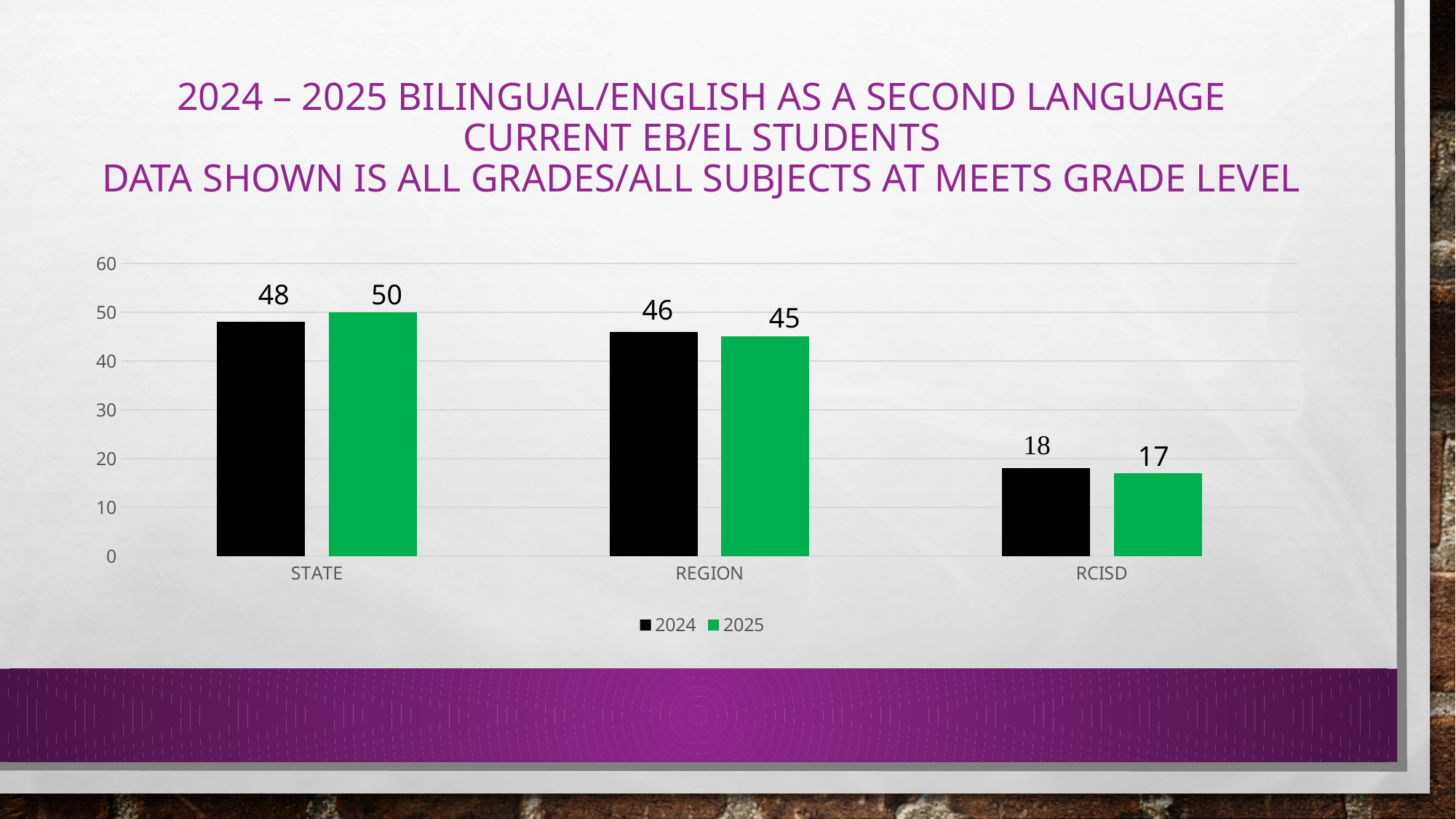
What is the 2025 value for RCISD? 17 How many categories are shown on the x axis? 3 Is the 2024 value for RCISD greater or less than 20? less Which category has the lowest 2024 value? RCISD Which is larger for REGION, the 2024 value or the 2025 value? 2024 What is the 2025 value for REGION? 45 What is the difference between the 2025 and 2024 values for STATE? 2 How many series does the legend list? 2 What kind of chart is shown on the slide? bar chart Which category has the highest 2025 value? STATE What is the difference between the 2024 values for REGION and RCISD? 28 What is the 2024 value for STATE? 48